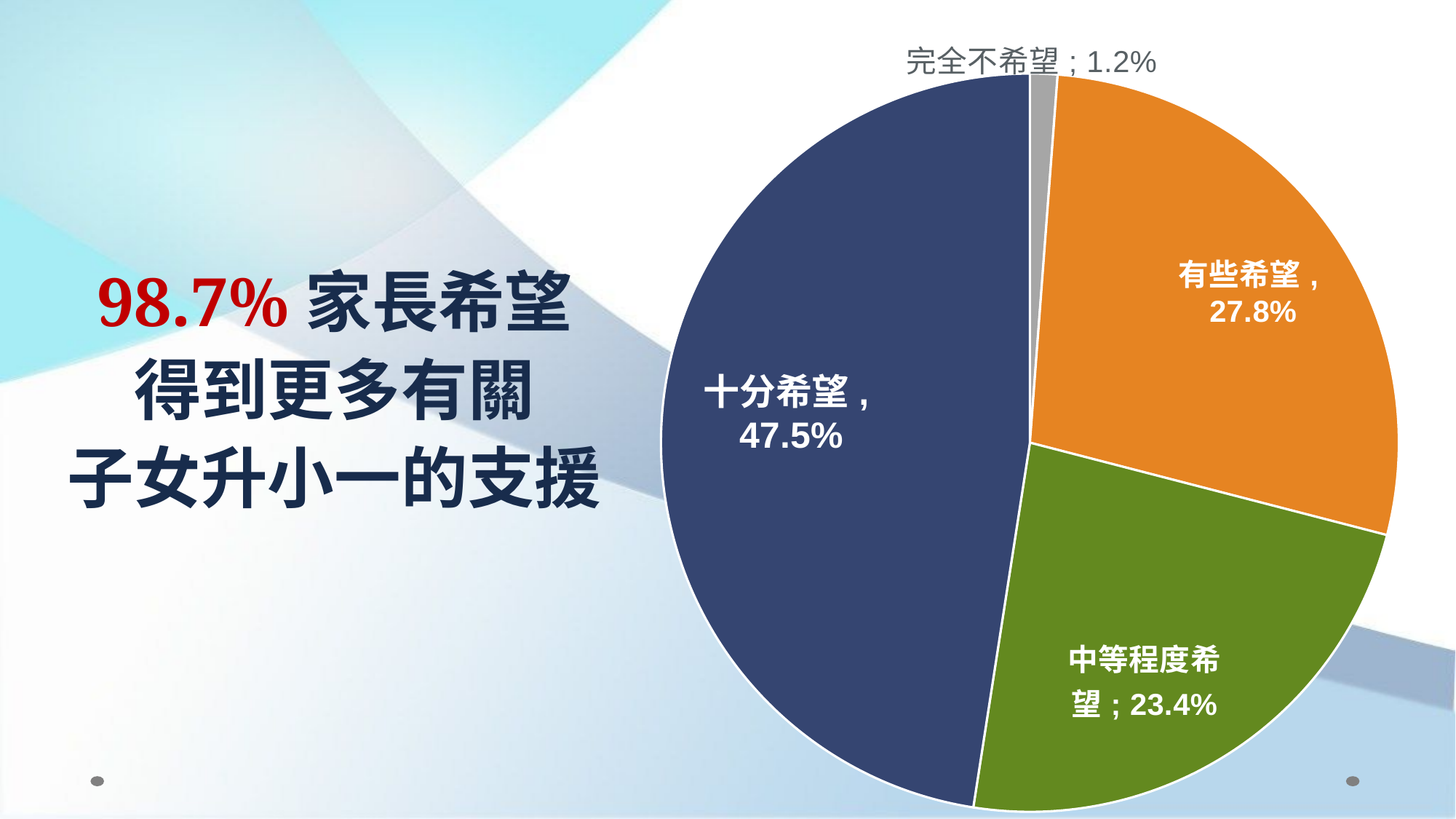
What share of the pie does 十分希望 represent? 47.5% What type of chart is shown on the slide? Pie chart What colour is the slice for 中等程度希望? Green What percentage is labelled for 中等程度希望? 23.4% How many slices does the pie chart have? 4 What is the value for 完全不希望? 1.2% Which category has the smallest slice of the pie? 完全不希望 What is the difference between the shares for 十分希望 and 有些希望? 19.7% What is the value shown for 有些希望? 27.8% Which is larger, the slice for 有些希望 or the slice for 中等程度希望? 有些希望 What is the difference between the shares for 有些希望 and 中等程度希望? 4.4% Which category has the largest slice of the pie? 十分希望